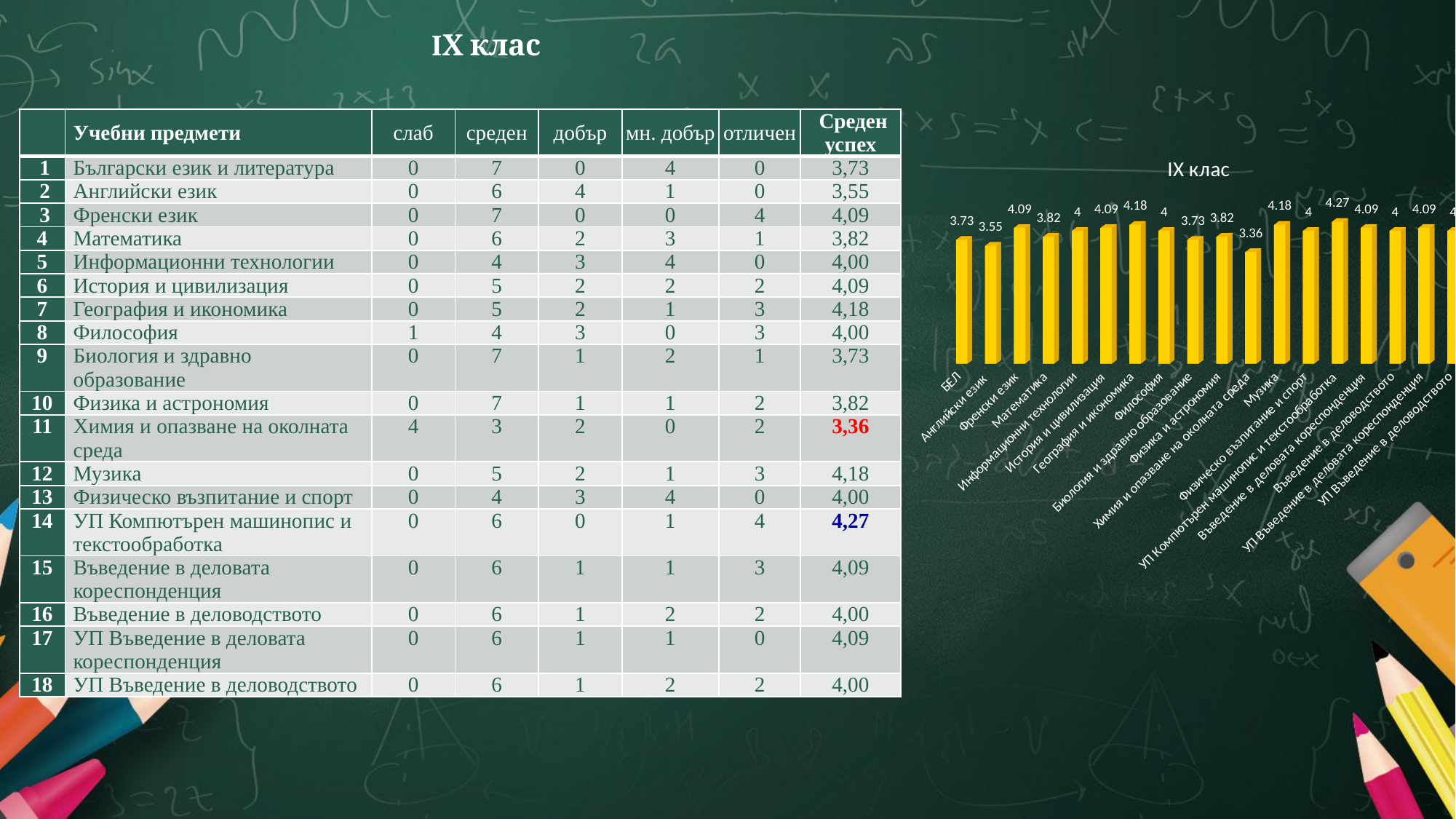
In the chart, what is the value for Английски език? 3.55 What is the title of the chart? IX клас What is the difference between the values for УП Компютърен машинопис и текстообработка and Химия и опазване на околната среда in the chart? 0.91 What is the difference between the values for Музика and Английски език in the chart? 0.63 Which category has the lowest value in the chart? Химия и опазване на околната среда In the chart, what is the value for География и икономика? 4.18 What type of chart is shown on the slide? bar chart Which category has the highest value in the chart? УП Компютърен машинопис и текстообработка In the chart, which is larger: the value for Френски език or the value for Математика? Френски език In the chart, what is the value for Химия и опазване на околната среда? 3.36 In the chart, what is the value for УП Компютърен машинопис и текстообработка? 4.27 In the chart, what is the value for БЕЛ? 3.73